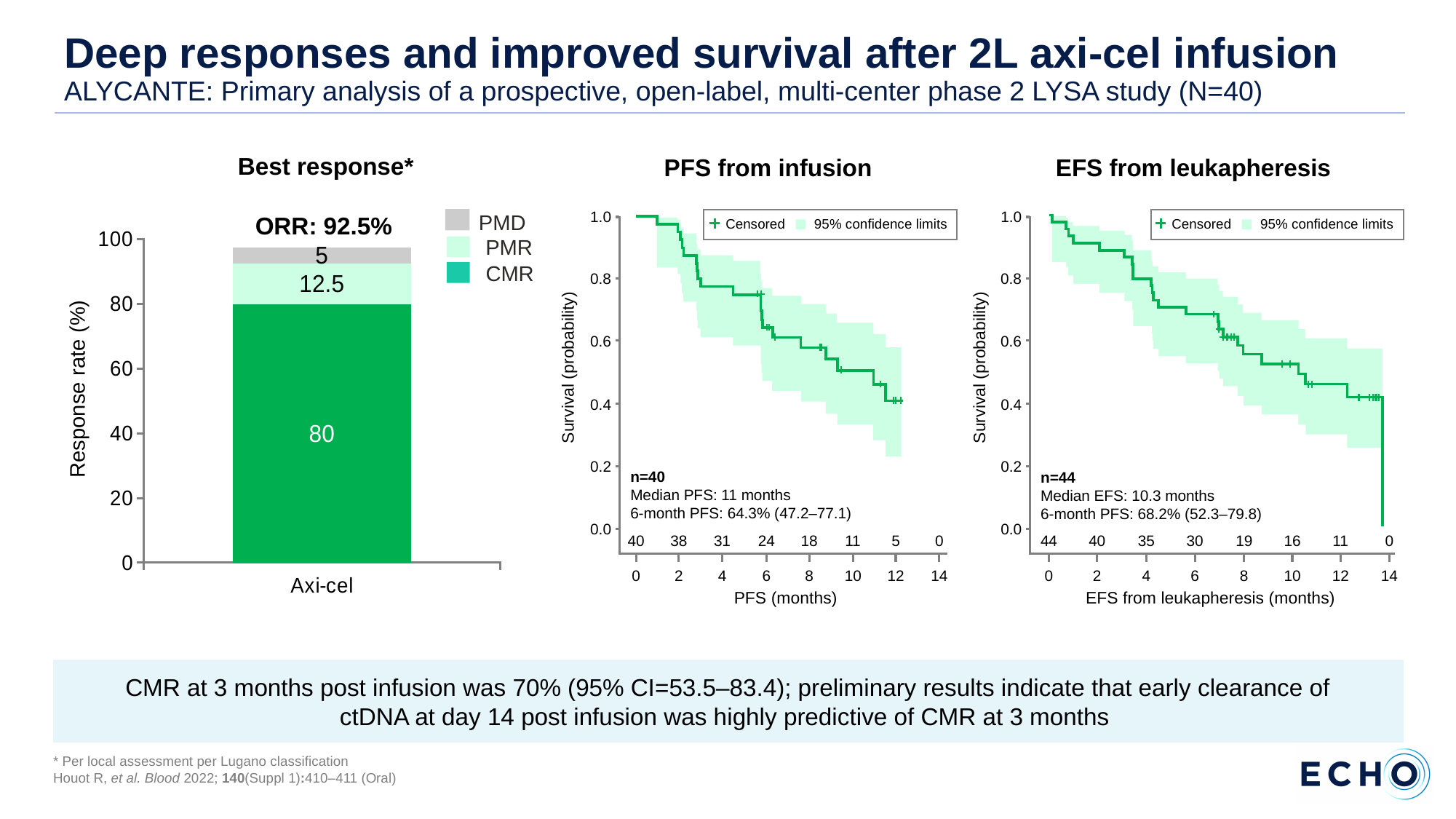
What kind of chart is the Best response chart? Stacked bar chart In the PFS from infusion chart, is the survival probability at 12 months greater or less than 0.6? less In the Best response chart, which response category has the largest segment? CMR In the EFS from leukapheresis chart, does the survival probability rise or fall over time? fall In the PFS from infusion chart, how many patients are at risk at 6 months? 24 In the Best response chart, what is the difference between the CMR and PMR rates? 67.5 In the Best response chart, what is the PMR rate for Axi-cel? 12.5 In the Best response chart, how many response categories does the legend list? 3 In the Best response chart, what is the PMD rate for Axi-cel? 5 In the Best response chart, what is the CMR rate for Axi-cel? 80 In the EFS from leukapheresis chart, how many patients are at risk at 8 months? 19 In the Best response chart, what ORR is printed above the bar? 92.5%